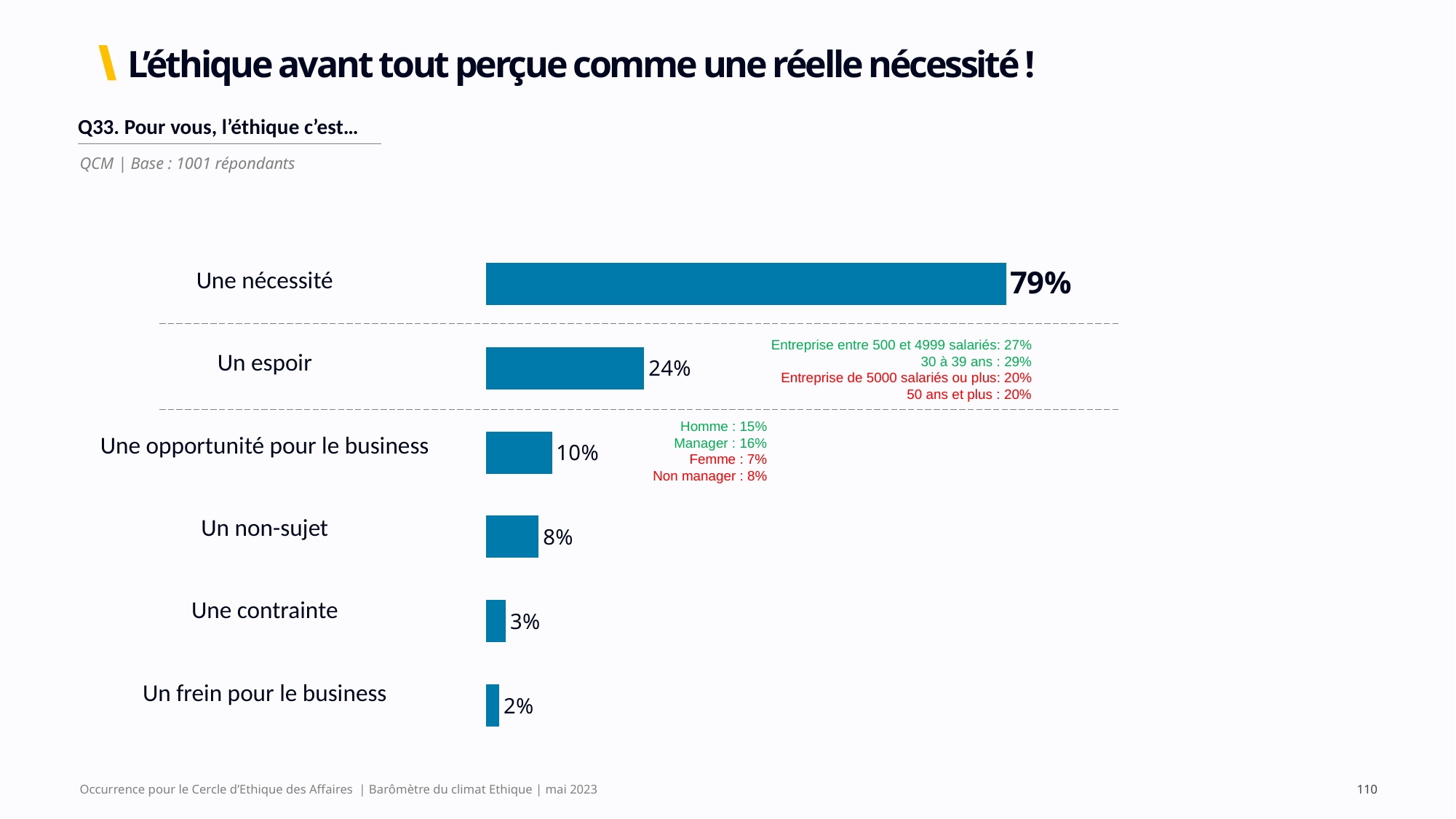
What is the base (number of respondents) stated for the chart? 1001 répondants What is the value for "Une nécessité"? 79% What is the value for "Une opportunité pour le business"? 10% What is the value for "Un frein pour le business"? 2% What kind of chart is shown on the slide? Bar chart What is the difference between the values for "Une nécessité" and "Un espoir"? 55% Which category has the lowest value? Un frein pour le business What is the value for "Un espoir"? 24% Which is larger, the value for "Une opportunité pour le business" or the value for "Un non-sujet"? Une opportunité pour le business How many categories are shown in the chart? 6 Which category has the highest value? Une nécessité What is the difference between the values for "Un non-sujet" and "Une contrainte"? 5%